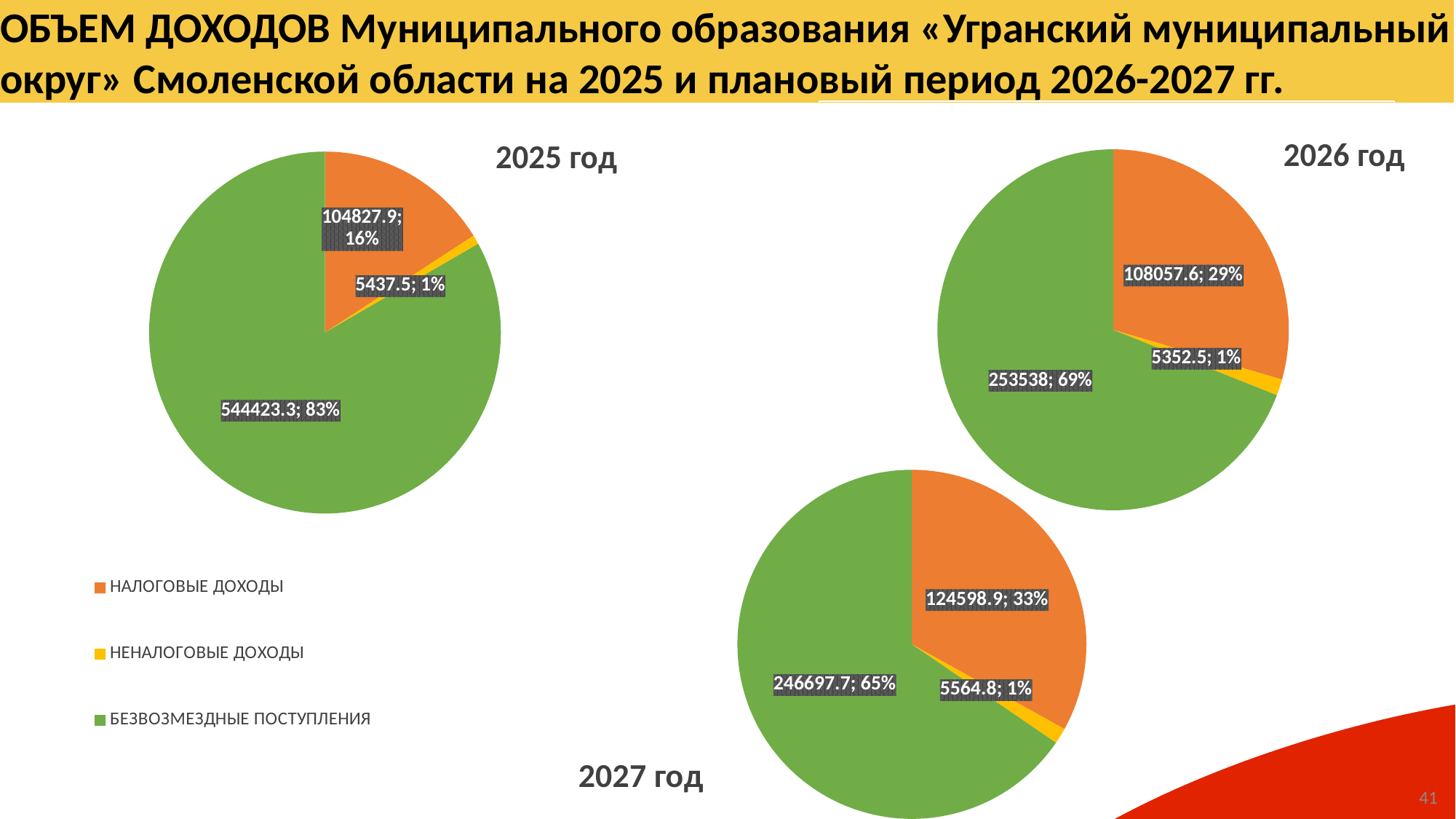
Which is larger: НАЛОГОВЫЕ ДОХОДЫ in the 2026 год chart or НАЛОГОВЫЕ ДОХОДЫ in the 2027 год chart? 2027 год In the 2027 год chart, what is the difference between the values for БЕЗВОЗМЕЗДНЫЕ ПОСТУПЛЕНИЯ and НАЛОГОВЫЕ ДОХОДЫ? 122098.8 In the 2027 год chart, which category has the largest slice? БЕЗВОЗМЕЗДНЫЕ ПОСТУПЛЕНИЯ What type of chart is used on this slide for the 2025 год data? Pie chart In the 2026 год chart, what is the value for БЕЗВОЗМЕЗДНЫЕ ПОСТУПЛЕНИЯ? 253538 In the 2027 год chart, what is the value for НЕНАЛОГОВЫЕ ДОХОДЫ? 5564.8 In the 2026 год chart, what share of the pie is НАЛОГОВЫЕ ДОХОДЫ? 29% In the 2025 год chart, which category has the smallest slice? НЕНАЛОГОВЫЕ ДОХОДЫ In the 2025 год chart, what is the value for НАЛОГОВЫЕ ДОХОДЫ? 104827.9 Which colour represents НЕНАЛОГОВЫЕ ДОХОДЫ in the pie charts? Yellow How many categories does the legend list for the pie charts? 3 In the 2025 год chart, what share of the pie is БЕЗВОЗМЕЗДНЫЕ ПОСТУПЛЕНИЯ? 83%